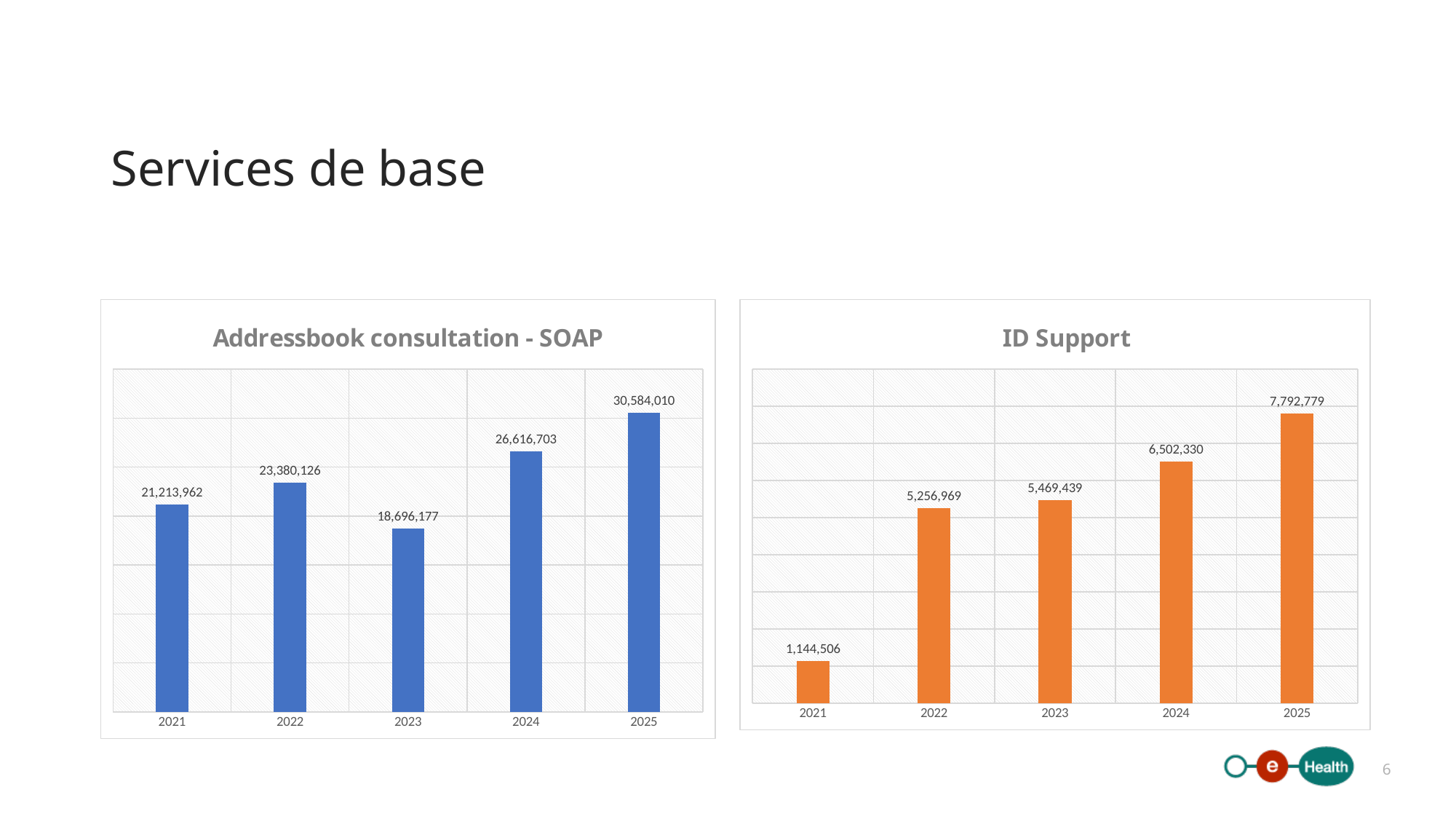
In the 'ID Support' chart, do the values rise or fall from 2021 to 2025? Rise How many years are shown in the 'ID Support' chart? 5 In the 'Addressbook consultation - SOAP' chart, which year has the highest value? 2025 What kind of chart is the 'ID Support' chart? Bar chart In the 'Addressbook consultation - SOAP' chart, what is the difference between the 2025 and 2024 values? 3,967,307 In the 'ID Support' chart, which year has the lowest value? 2021 In the 'ID Support' chart, what is the value for 2021? 1,144,506 In the 'Addressbook consultation - SOAP' chart, which year has the lowest value? 2023 In the 'Addressbook consultation - SOAP' chart, which is larger, the value for 2021 or the value for 2022? 2022 In the 'Addressbook consultation - SOAP' chart, what is the value for 2023? 18,696,177 In the 'ID Support' chart, what is the difference between the 2025 and 2024 values? 1,290,449 In the 'ID Support' chart, which is larger, the value for 2022 or the value for 2023? 2023